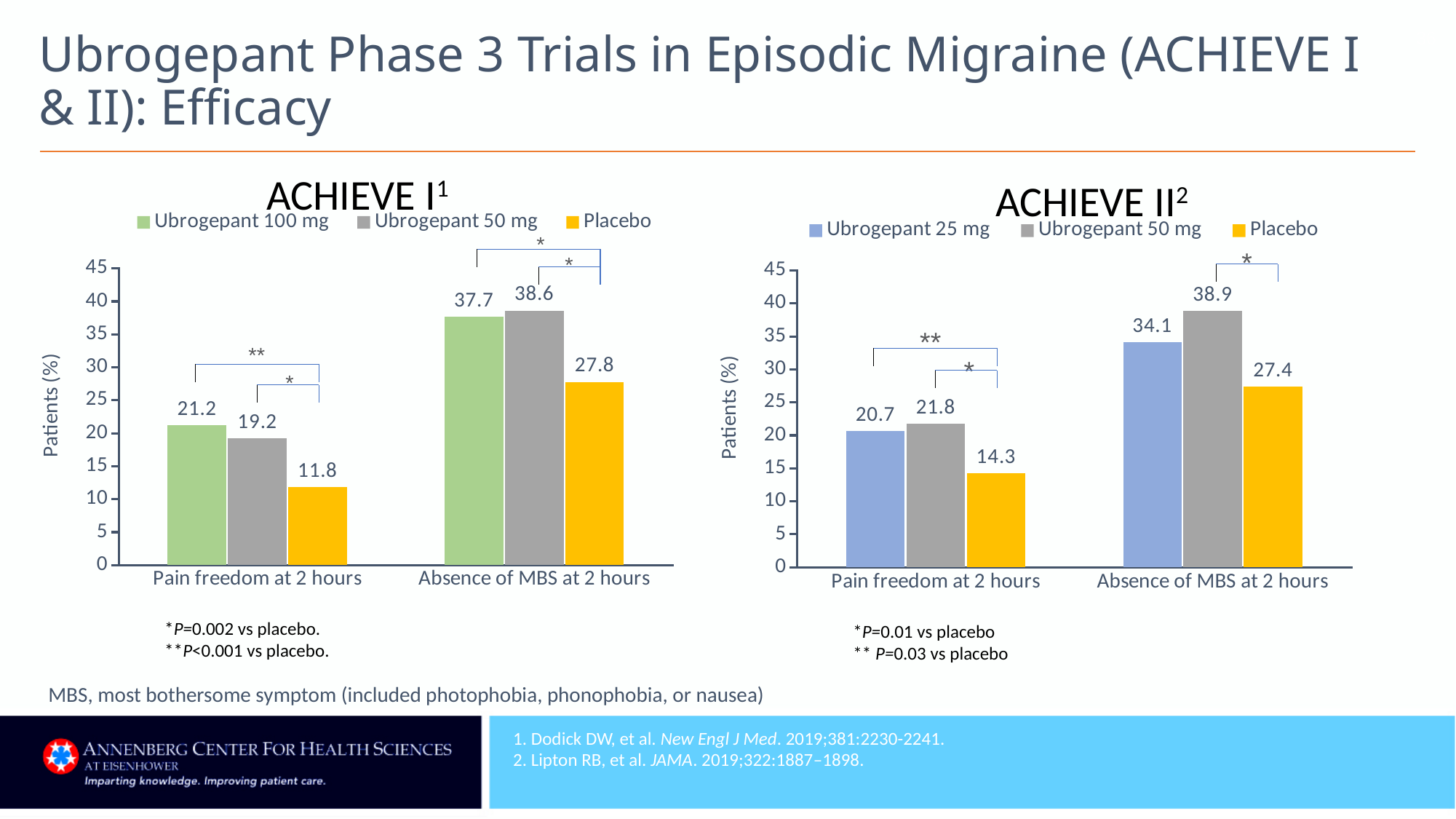
In the ACHIEVE I chart, what is the difference between Ubrogepant 100 mg and Placebo for Pain freedom at 2 hours? 9.4 In the ACHIEVE I chart, which is larger for Pain freedom at 2 hours: Ubrogepant 100 mg or Ubrogepant 50 mg? Ubrogepant 100 mg What is the y-axis label of the ACHIEVE II chart? Patients (%) In the ACHIEVE II chart, which series has the lowest value for Pain freedom at 2 hours? Placebo In the ACHIEVE II chart, what is the value for Ubrogepant 25 mg for Pain freedom at 2 hours? 20.7 In the ACHIEVE II chart, what is the difference between Ubrogepant 50 mg and Placebo for Absence of MBS at 2 hours? 11.5 In the ACHIEVE I chart, which series has the highest value for Absence of MBS at 2 hours? Ubrogepant 50 mg How many series does the legend of the ACHIEVE II chart list? 3 In the ACHIEVE I chart, what is the value for Ubrogepant 100 mg for Pain freedom at 2 hours? 21.2 In the ACHIEVE I chart, what is the value for Placebo for Absence of MBS at 2 hours? 27.8 In the ACHIEVE II chart, what is the value for Ubrogepant 50 mg for Absence of MBS at 2 hours? 38.9 What kind of chart is the ACHIEVE I chart? Bar chart